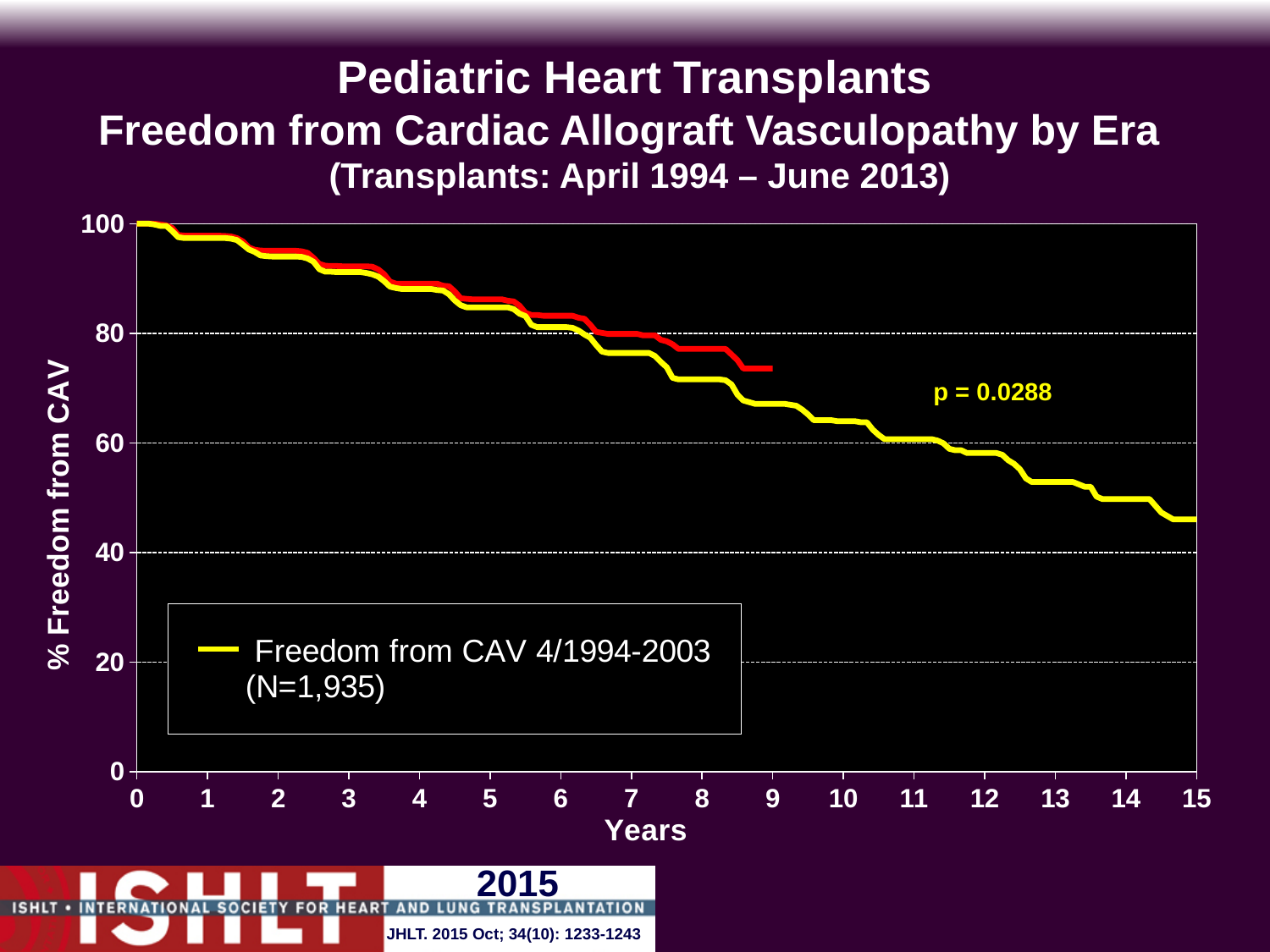
Does the yellow line rise or fall as the years increase? fall Is the value of the red line at year 9 greater or less than 60? greater What is the highest value shown on the x axis? 15 What kind of chart is shown on the slide? line chart Is the value of the yellow line at year 15 greater or less than 60? less Is the value of the yellow line at year 14 greater or less than 60? less At year 8, which line is higher, the red line or the yellow line? red line What is the legend entry for the yellow line? Freedom from CAV 4/1994-2003 (N=1,935) What is the label of the y axis? % Freedom from CAV What p-value is printed on the chart? p = 0.0288 How many series does the legend list? 1